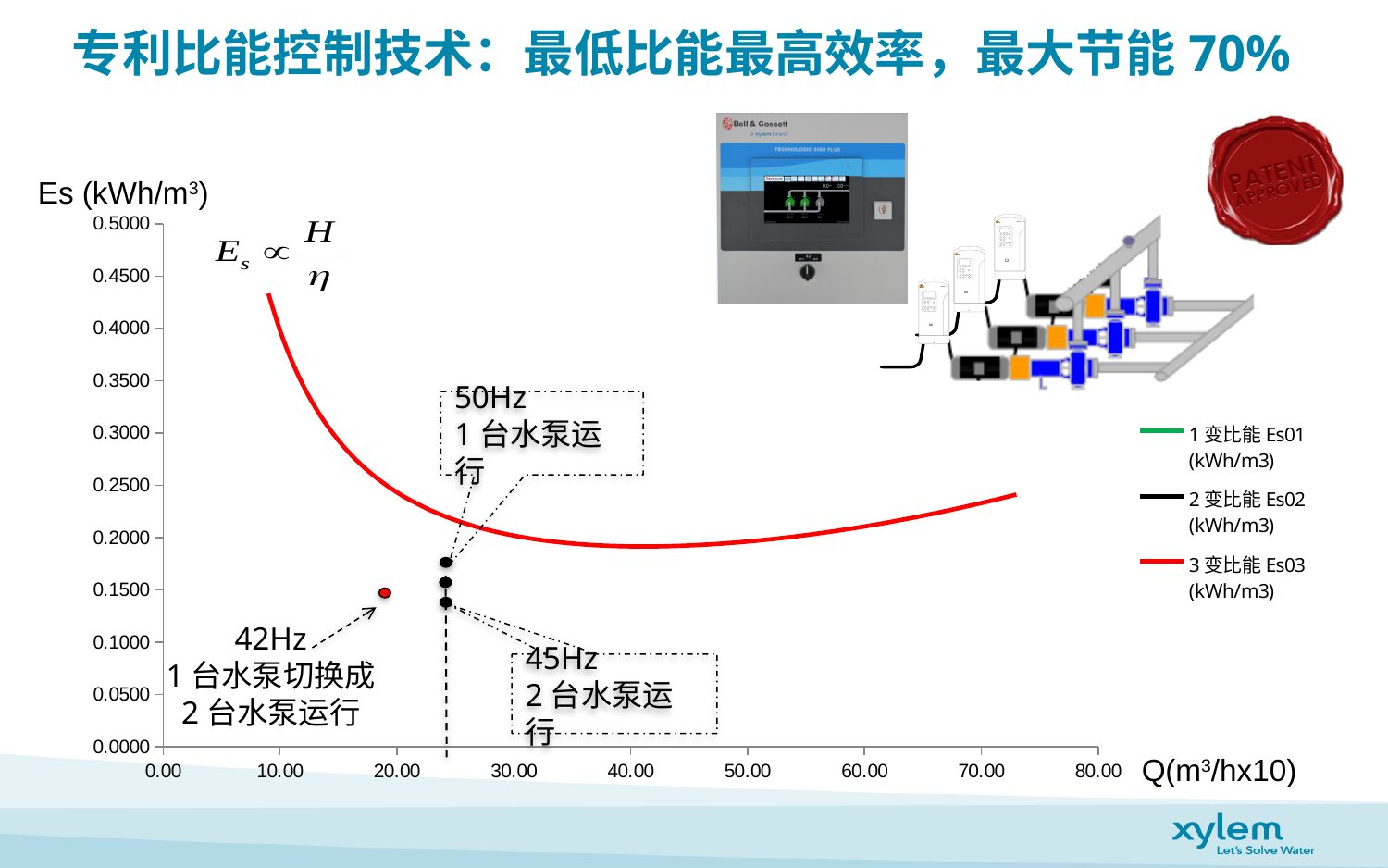
What is the label of the vertical axis of the chart? Es (kWh/m³) Is the value of the red curve (3 变比能 Es03) at Q = 40.00 greater or less than 0.3000? less How many series does the chart legend list? 3 What is the highest tick value shown on the vertical axis of the chart? 0.5000 Does the red curve (3 变比能 Es03) rise or fall as Q increases from 10.00 to 40.00? fall Does the red curve (3 变比能 Es03) rise or fall as Q increases from 50.00 to 70.00? rise Which series is drawn as the red curve in the chart? 3 变比能 Es03 (kWh/m3) Is the value of the red curve (3 变比能 Es03) at Q = 70.00 greater or less than 0.3000? less Which is larger: the value of the red curve at Q = 10.00 or at Q = 40.00? Q = 10.00 What kind of chart is shown on the slide? line chart How many black data points are plotted on the chart? 3